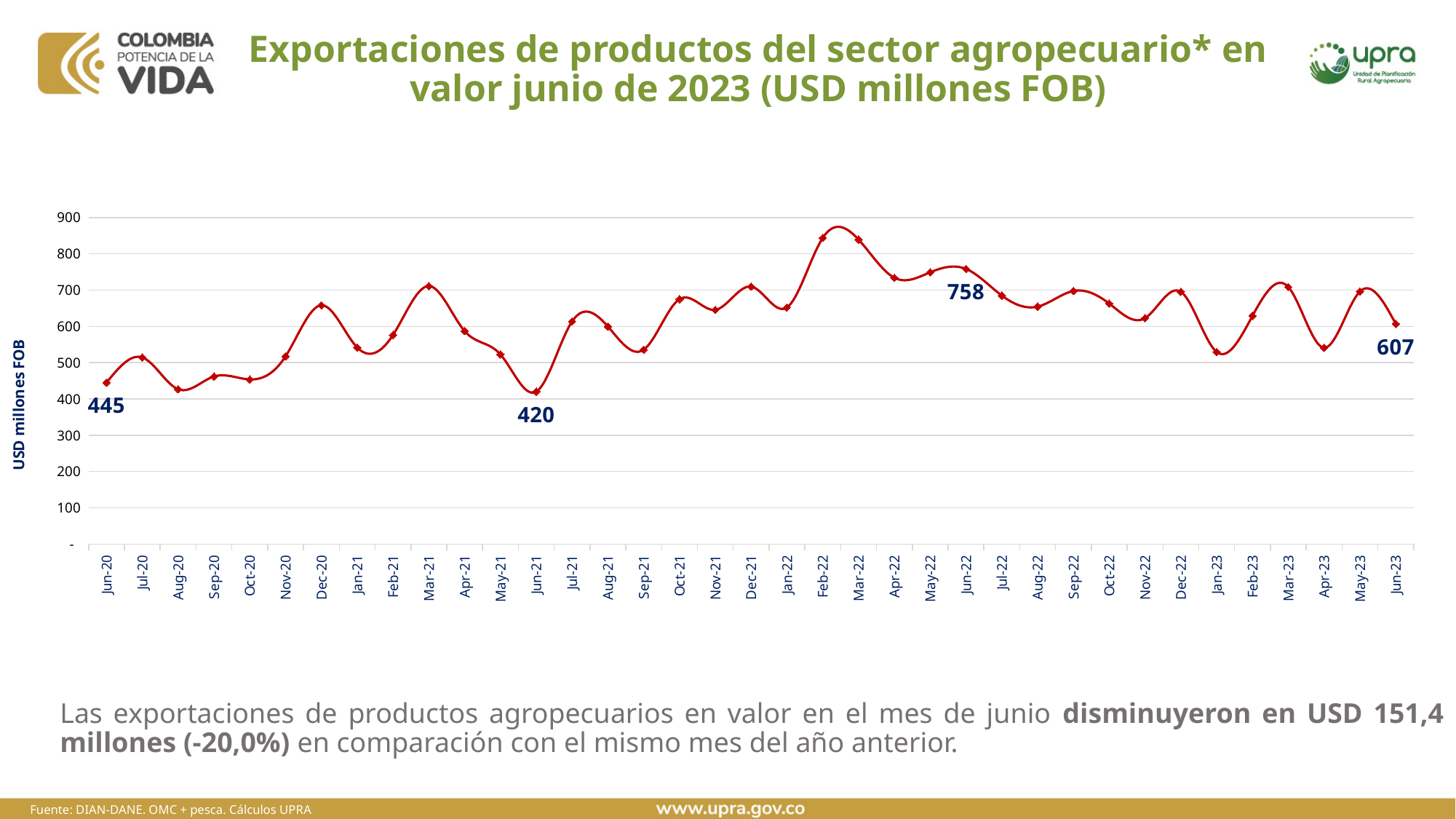
What is the value for Jun-21? 420 What is the label of the vertical axis? USD millones FOB What is the value for Jun-20? 445 Which month has the highest value on the chart? Feb-22 What is the value for Jun-22? 758 What is the difference between the values for Jun-22 and Jun-23? 151 Is the value for Jan-23 greater or less than 600? less What kind of chart is shown on the slide? line chart What is the value for Jun-23? 607 Which is larger, the value for Jun-20 or the value for Jun-21? Jun-20 How many monthly data points are plotted on the chart? 37 Is the value for Feb-22 greater or less than 800? greater